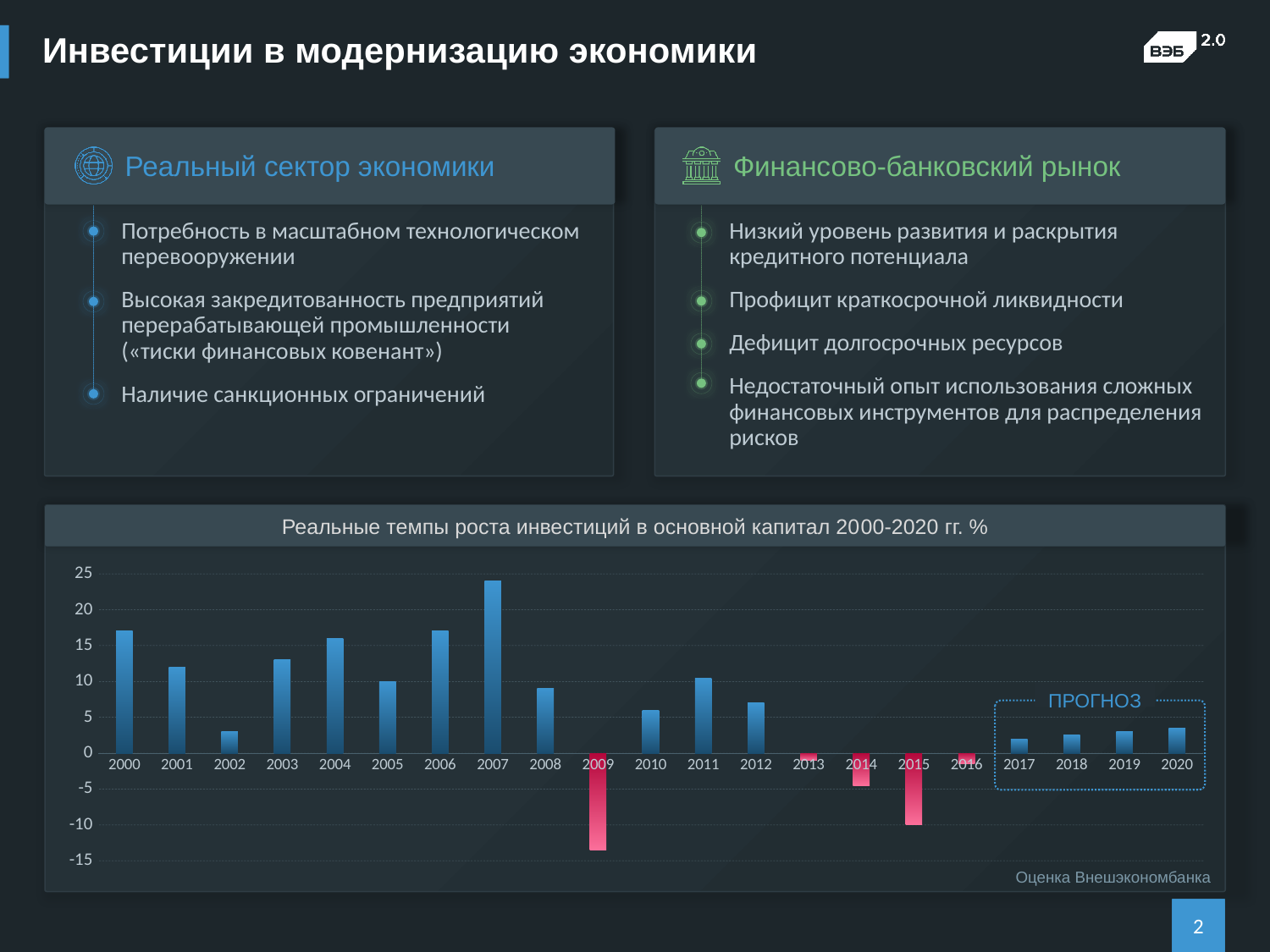
Is the value for 2009 greater or less than -10? less Is the value for 2002 greater or less than 5? less Is the value for 2007 greater or less than 20? greater Which years are covered by the dashed box labelled ПРОГНОЗ? 2017–2020 Which year has the highest value in the chart? 2007 Which year has the lowest value in the chart? 2009 Do the values rise or fall from 2017 to 2020 in the forecast (ПРОГНОЗ) section? rise What is the title of the chart on the slide? Реальные темпы роста инвестиций в основной капитал 2000-2020 гг. % How many years (categories) are plotted on the x axis of the chart? 21 Which year has the larger value, 2001 or 2002? 2001 What kind of chart is shown at the bottom of the slide? bar chart